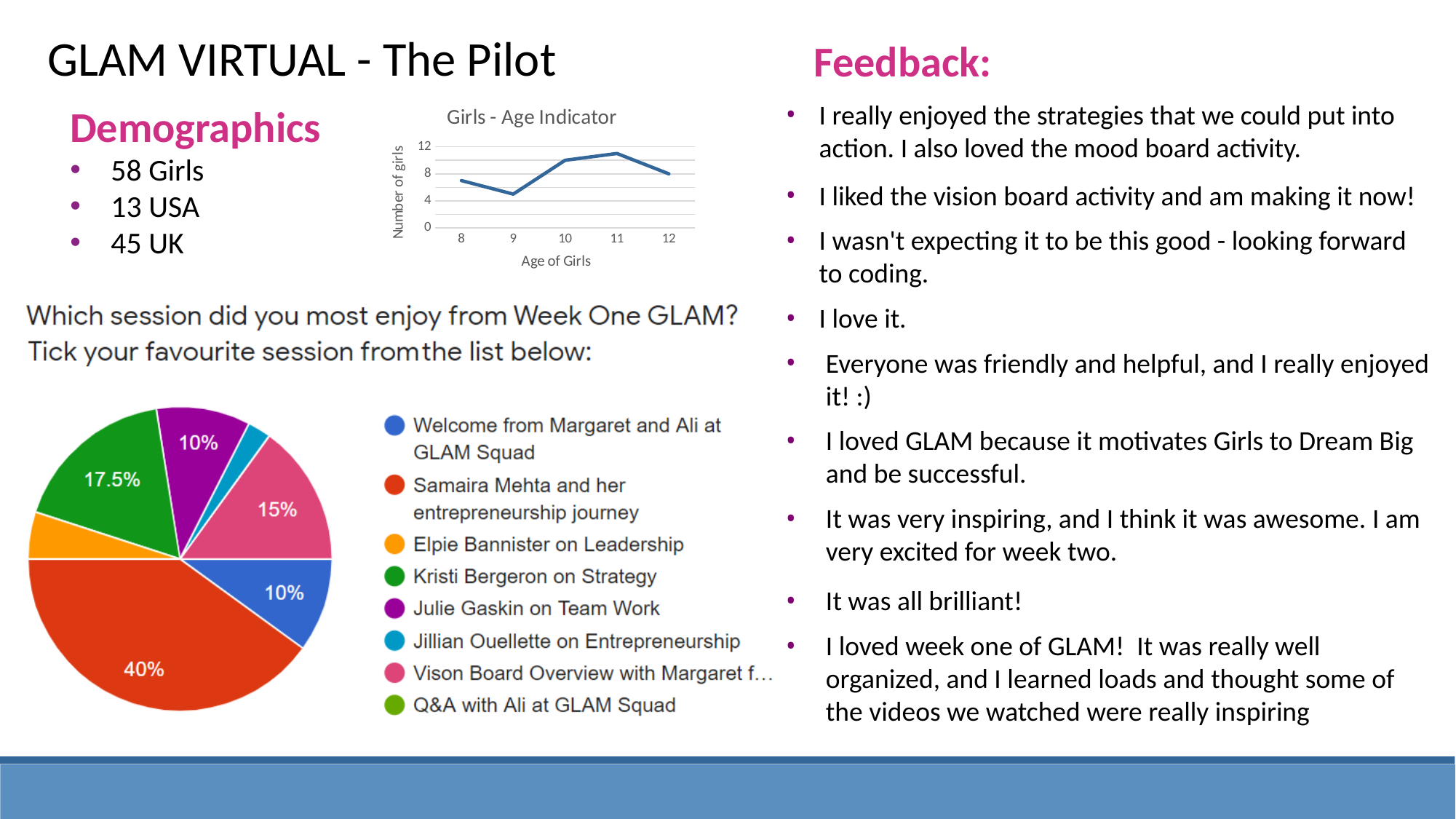
What kind of chart is the 'Girls - Age Indicator' chart? line chart In the pie chart of favourite Week One sessions, which session has the largest slice? Samaira Mehta and her entrepreneurship journey How many ages are plotted on the x axis of the 'Girls - Age Indicator' chart? 5 In the 'Girls - Age Indicator' chart, which age has the lowest number of girls? 9 In the pie chart of favourite Week One sessions, how many sessions does the legend list? 8 In the 'Girls - Age Indicator' chart, which has more girls: age 10 or age 9? age 10 In the 'Girls - Age Indicator' chart, is the number of girls aged 10 greater or less than 8? greater In the 'Girls - Age Indicator' chart, does the number of girls rise or fall from age 9 to age 11? rise In the pie chart of favourite Week One sessions, what share chose 'Kristi Bergeron on Strategy'? 17.5% In the 'Girls - Age Indicator' chart, is the number of girls aged 9 greater or less than 8? less In the 'Girls - Age Indicator' chart, which age has the highest number of girls? 11 In the pie chart of favourite Week One sessions, what share chose 'Samaira Mehta and her entrepreneurship journey'? 40%